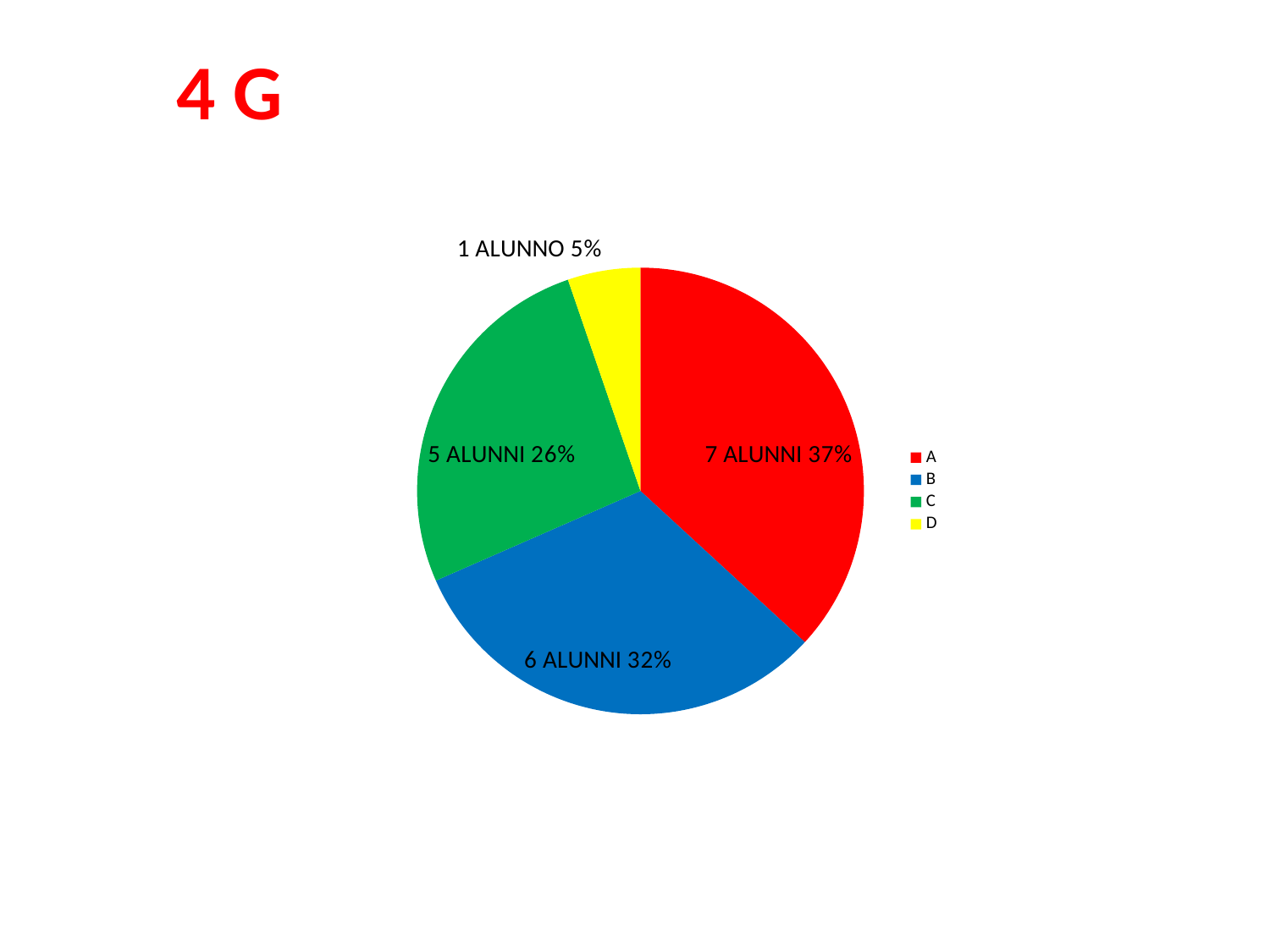
Which category has the smallest slice of the pie? D What colour is the slice for category D? yellow What share of the pie does category B have? 32% Which category has the largest slice of the pie? A What share of the pie does category C have? 26% What share of the pie does category D have? 5% What kind of chart is shown on the slide? pie chart How many students (alunni) are in category A? 7 What is the difference in percentage points between category A and category B? 5 How many categories does the legend list? 4 How many students (alunni) are in category C? 5